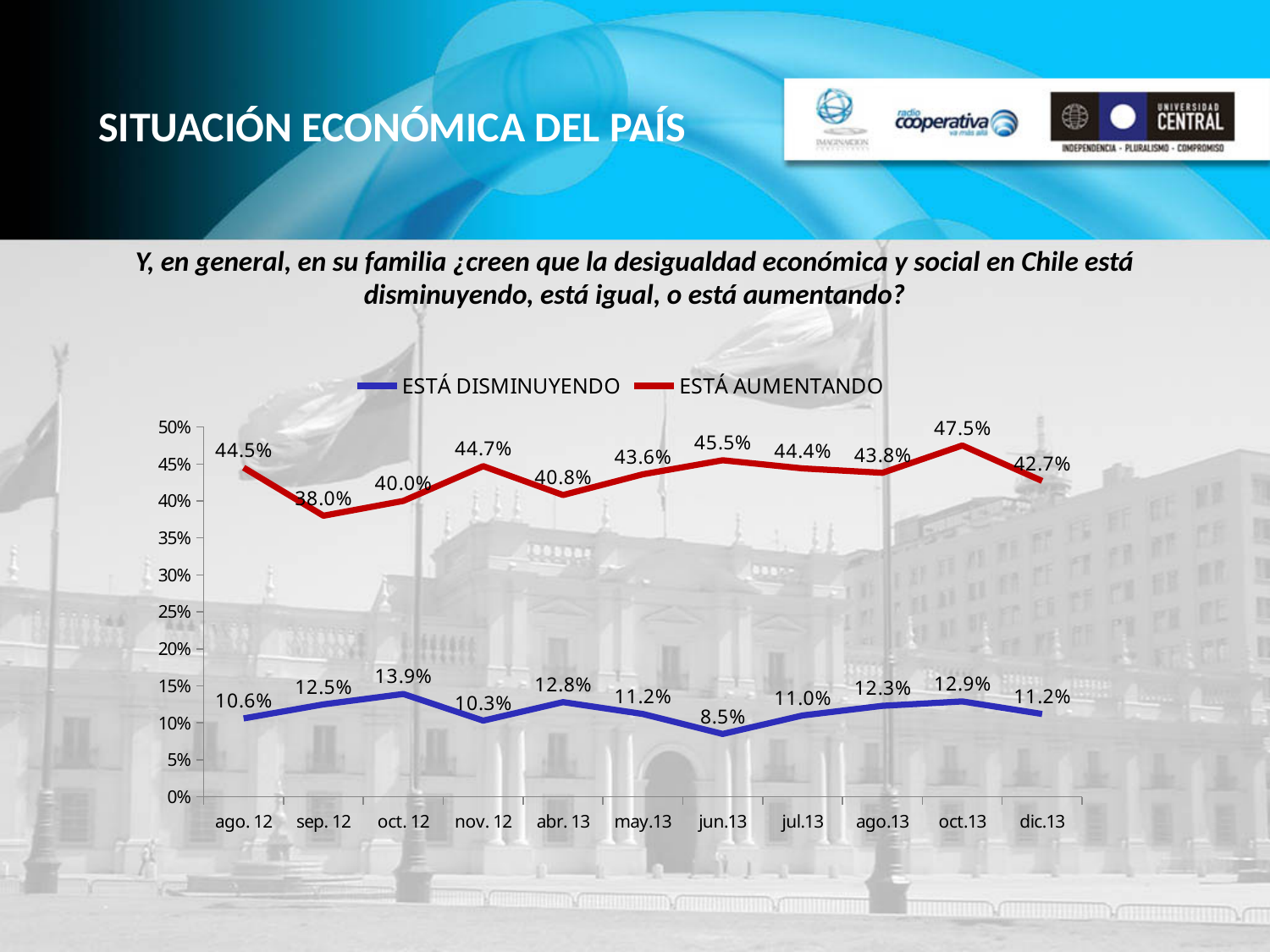
What is the value for ESTÁ DISMINUYENDO in jun.13? 8.5% What is the value for ESTÁ AUMENTANDO in oct.13? 47.5% In which period is ESTÁ DISMINUYENDO highest? oct. 12 What kind of chart is shown on the slide? line chart What is the value for ESTÁ AUMENTANDO in sep. 12? 38.0% In which period is ESTÁ AUMENTANDO highest? oct.13 How many time periods are shown on the x axis? 11 How many series does the legend list? 2 What is the difference between ESTÁ AUMENTANDO and ESTÁ DISMINUYENDO in dic.13? 31.5% Is the value for ESTÁ AUMENTANDO in jun.13 greater or less than 40%? greater In which period is ESTÁ DISMINUYENDO lowest? jun.13 Which is larger for ESTÁ DISMINUYENDO: oct. 12 or nov. 12? oct. 12